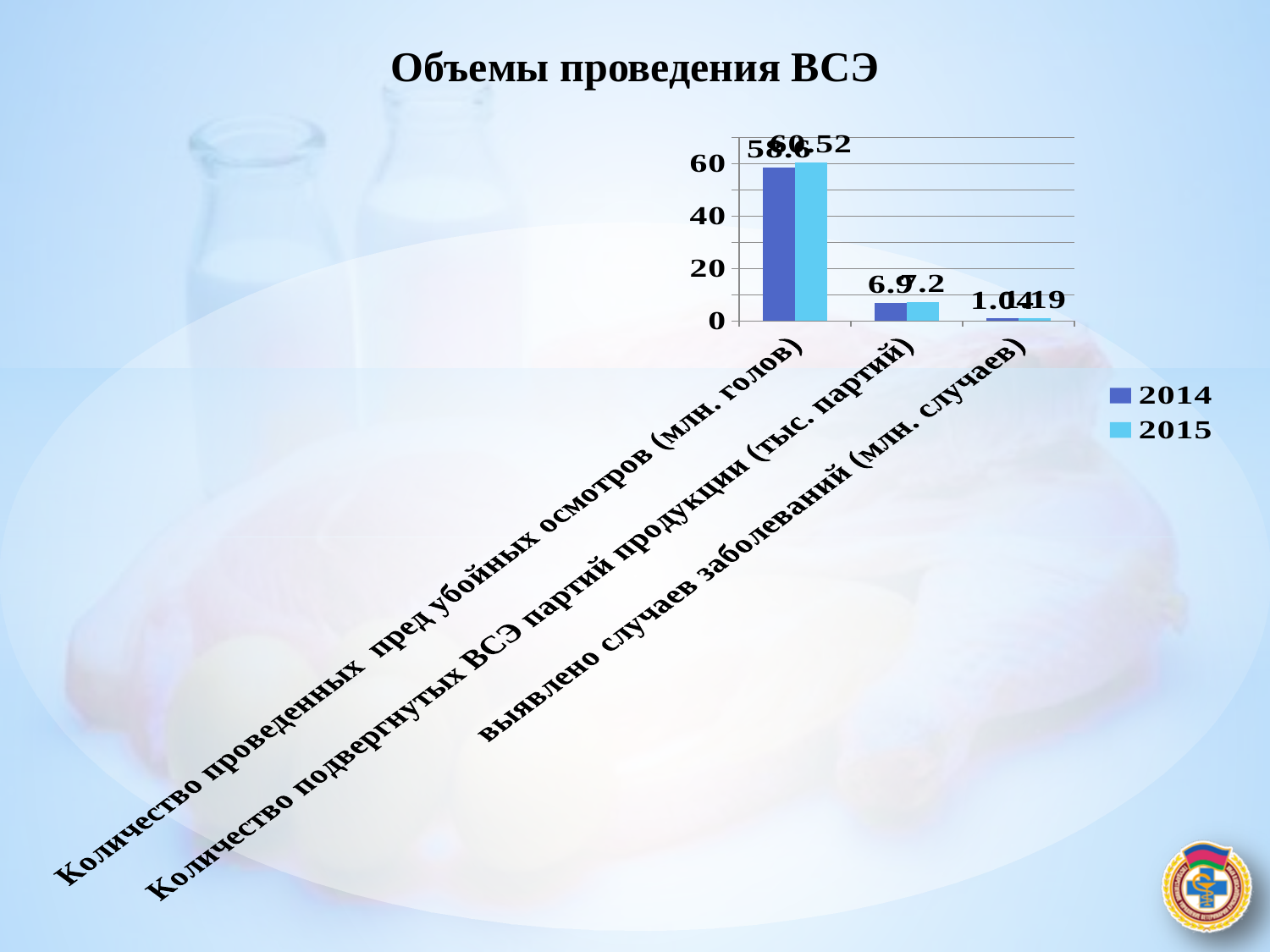
Which category has the highest values in the chart? Количество проведенных предубойных осмотров (млн. голов) How many categories are shown on the x axis of the chart? 3 Which category has the lowest values in the chart? выявлено случаев заболеваний (млн. случаев) What is the 2015 value for "Количество подвергнутых ВСЭ партий продукции (тыс. партий)"? 7.2 What is the difference between the 2015 and 2014 values for "Количество проведенных предубойных осмотров (млн. голов)"? 1.92 How many series does the legend list? 2 What is the title of the slide containing the chart? Объемы проведения ВСЭ What kind of chart is shown on the slide? bar chart Is the 2015 value for "Количество проведенных предубойных осмотров (млн. голов)" greater or less than 40? greater What is the 2014 value for "Количество проведенных предубойных осмотров (млн. голов)"? 58.6 For "Количество проведенных предубойных осмотров (млн. голов)", which year has the larger value, 2014 or 2015? 2015 What is the 2015 value for "Количество проведенных предубойных осмотров (млн. голов)"? 60.52